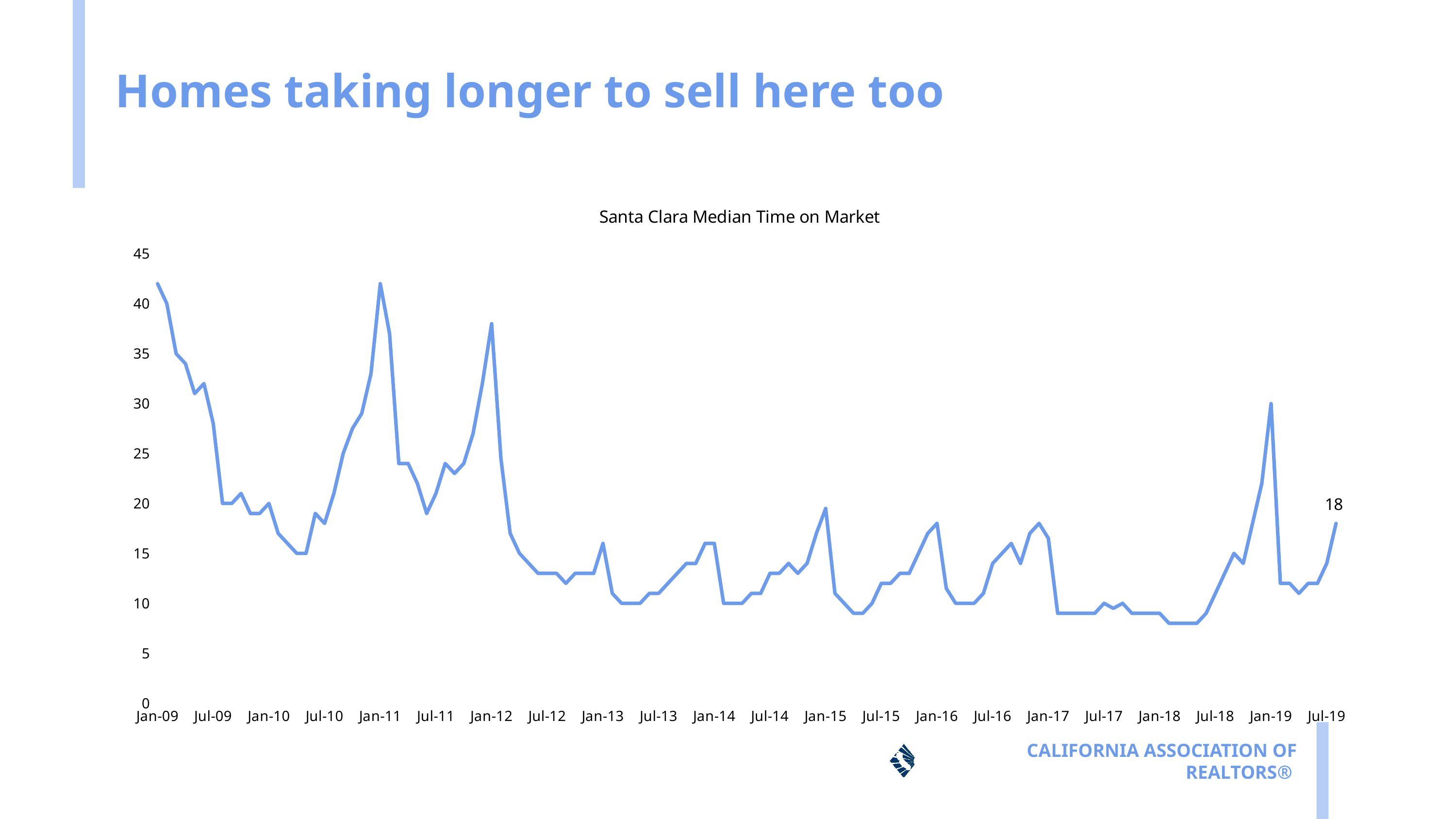
Do the values rise or fall between Jan-09 and Jul-09? fall Is the value for Jan-09 greater or less than 40? greater Is the value for Jan-12 greater or less than 35? greater Is the value for Jan-18 greater or less than 10? less What is the highest value shown on the vertical axis? 45 Do the values rise or fall between Jul-18 and Jan-19? rise Which is larger, the value at Jan-09 or the value at Jul-19? Jan-09 What is the title of the chart? Santa Clara Median Time on Market What kind of chart is shown on the slide? line chart Which is larger, the value at Jan-19 or the value at Jan-18? Jan-19